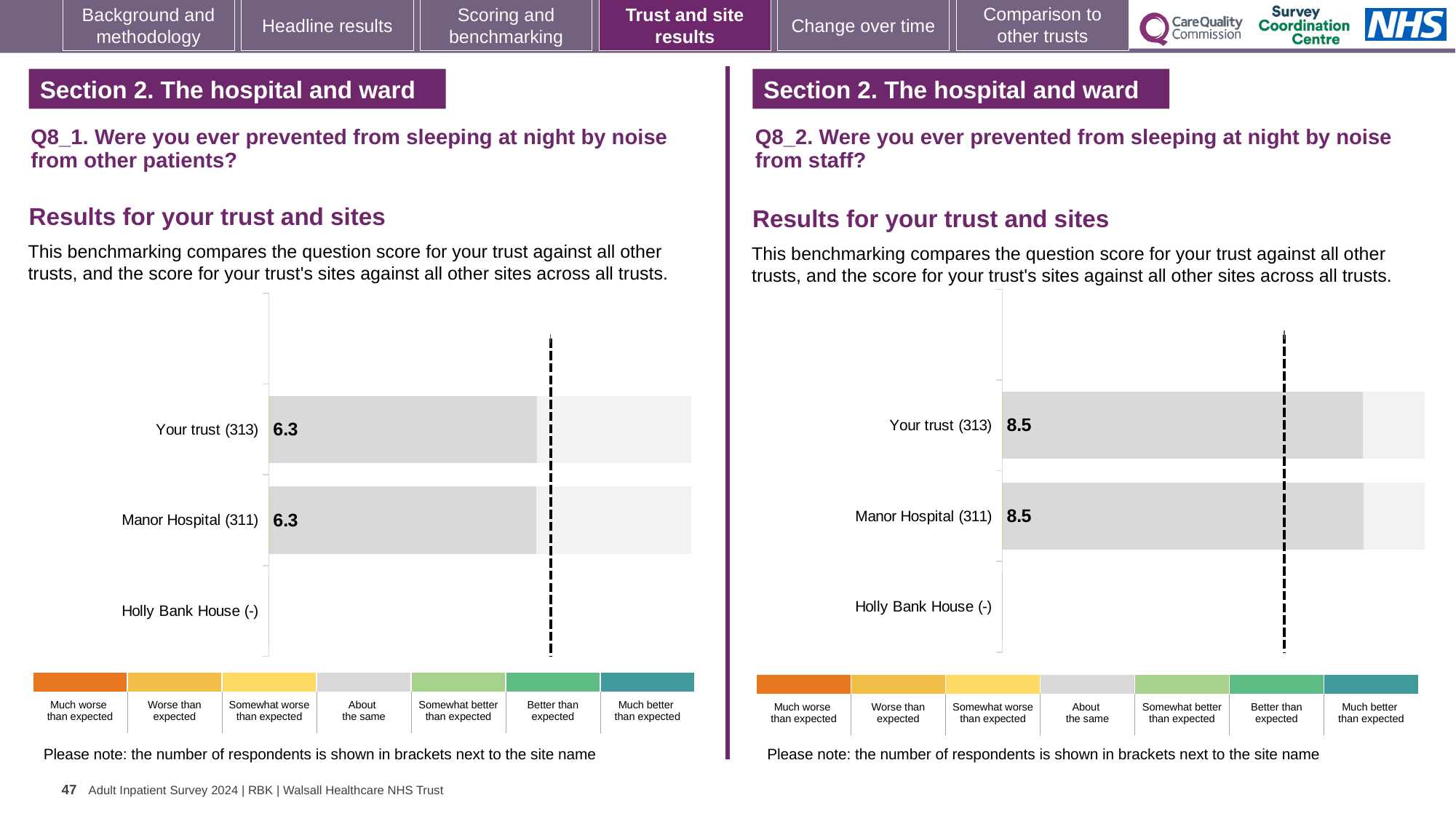
On the Q8_2 chart (noise from staff), what is the score for Manor Hospital (311)? 8.5 On the Q8_1 chart, what is the difference between the scores for Your trust (313) and Manor Hospital (311)? 0 On the Q8_2 chart, which category has no score bar shown? Holly Bank House (-) How many site/trust categories are listed on the Q8_2 chart? 3 On the Q8_1 chart (noise from other patients), what is the score for Manor Hospital (311)? 6.3 On the Q8_2 chart (noise from staff), what is the score for Your trust (313)? 8.5 On the Q8_2 chart, what is the difference between the scores for Your trust (313) and Manor Hospital (311)? 0 On the Q8_1 chart (noise from other patients), what is the score for Your trust (313)? 6.3 What kind of chart is used for the Q8_1 results? Bar chart Is the Your trust (313) score on the Q8_2 chart larger than the Your trust (313) score on the Q8_1 chart? Yes How many site/trust categories are listed on the Q8_1 chart? 3 How many respondents are shown in brackets for Manor Hospital on the Q8_1 chart? 311